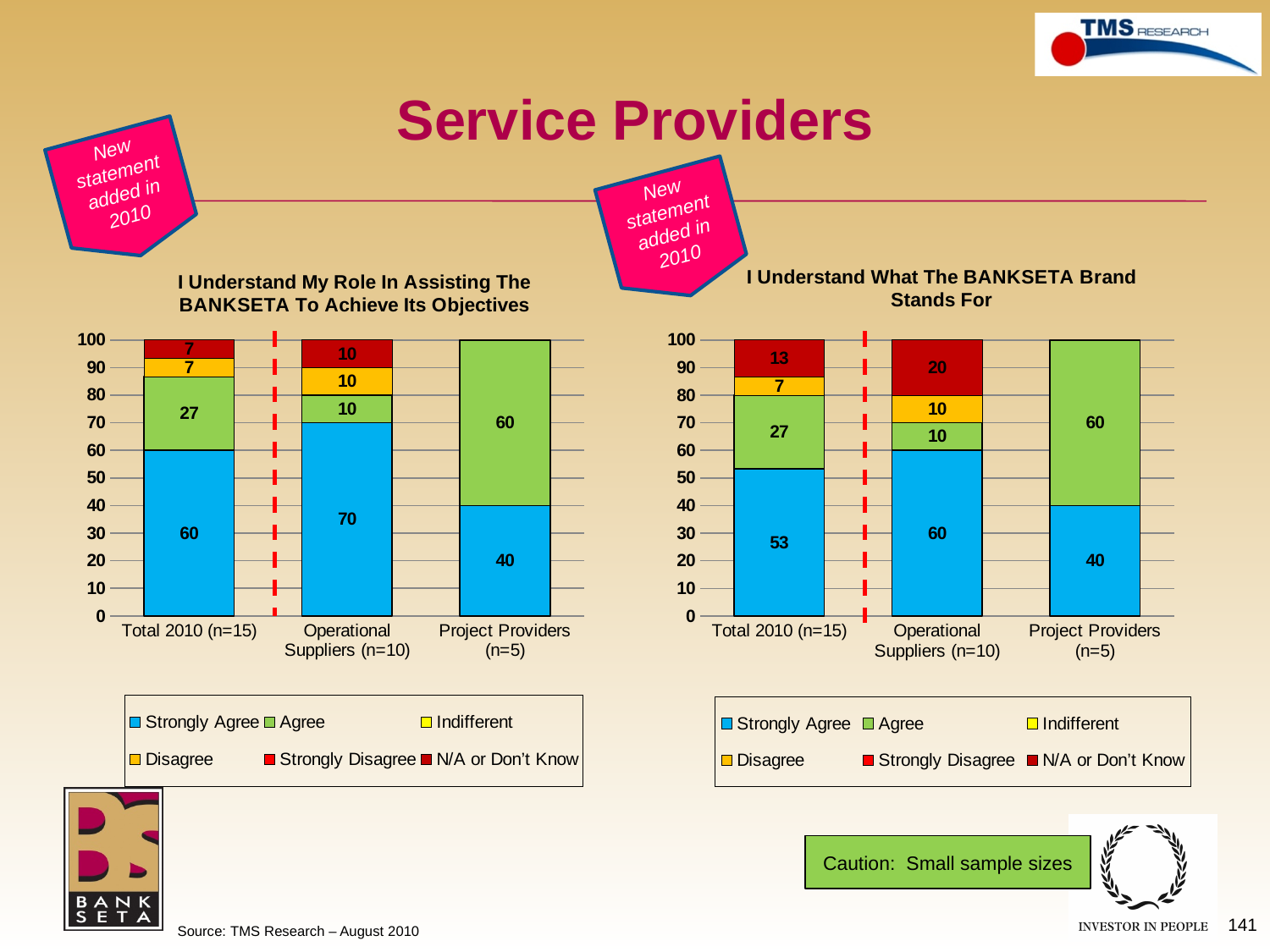
In the chart 'I Understand What The BANKSETA Brand Stands For', what is the Strongly Agree value for Total 2010 (n=15)? 53 In the chart 'I Understand What The BANKSETA Brand Stands For', which category has the lowest Strongly Agree value? Project Providers (n=5) In the chart 'I Understand My Role In Assisting The BANKSETA To Achieve Its Objectives', what is the total of the stacked bar for Project Providers (n=5)? 100 In the chart 'I Understand My Role In Assisting The BANKSETA To Achieve Its Objectives', which category has the highest Strongly Agree value? Operational Suppliers (n=10) How many categories are shown on the x axis of the chart 'I Understand What The BANKSETA Brand Stands For'? 3 In the chart 'I Understand What The BANKSETA Brand Stands For', what is the Agree value for Project Providers (n=5)? 60 How many series does the legend of the chart 'I Understand My Role In Assisting The BANKSETA To Achieve Its Objectives' list? 6 What kind of chart is 'I Understand What The BANKSETA Brand Stands For'? Stacked bar chart In the chart 'I Understand My Role In Assisting The BANKSETA To Achieve Its Objectives', what is the Strongly Agree value for Operational Suppliers (n=10)? 70 In the chart 'I Understand What The BANKSETA Brand Stands For', what is the difference between the Strongly Agree values for Operational Suppliers (n=10) and Total 2010 (n=15)? 7 In the chart 'I Understand My Role In Assisting The BANKSETA To Achieve Its Objectives', what is the Agree value for Total 2010 (n=15)? 27 In the chart 'I Understand My Role In Assisting The BANKSETA To Achieve Its Objectives', is the Agree value larger for Project Providers (n=5) or for Operational Suppliers (n=10)? Project Providers (n=5)